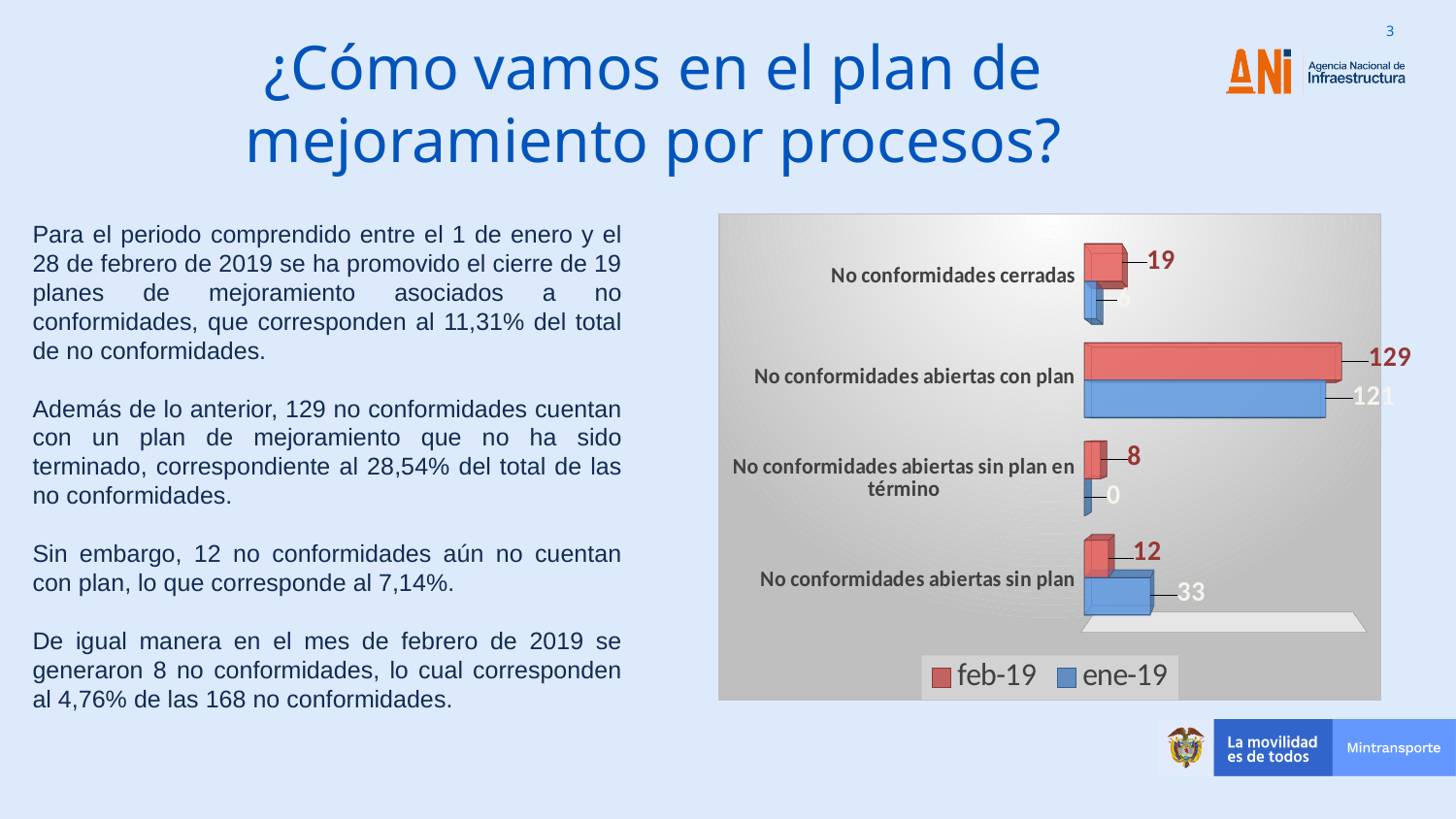
Which category has the lowest feb-19 value? No conformidades abiertas sin plan en término What kind of chart is shown on the slide? bar chart How many series does the chart legend list? 2 What is the feb-19 value for 'No conformidades abiertas con plan'? 129 How many categories are shown on the chart? 4 Which category has the highest feb-19 value? No conformidades abiertas con plan For 'No conformidades abiertas sin plan', which series has the larger value, feb-19 or ene-19? ene-19 What is the feb-19 value for 'No conformidades abiertas sin plan en término'? 8 For 'No conformidades abiertas sin plan', what is the difference between the ene-19 value and the feb-19 value? 21 What is the ene-19 value for 'No conformidades abiertas sin plan en término'? 0 What is the feb-19 value for 'No conformidades cerradas'? 19 What is the ene-19 value for 'No conformidades abiertas sin plan'? 33